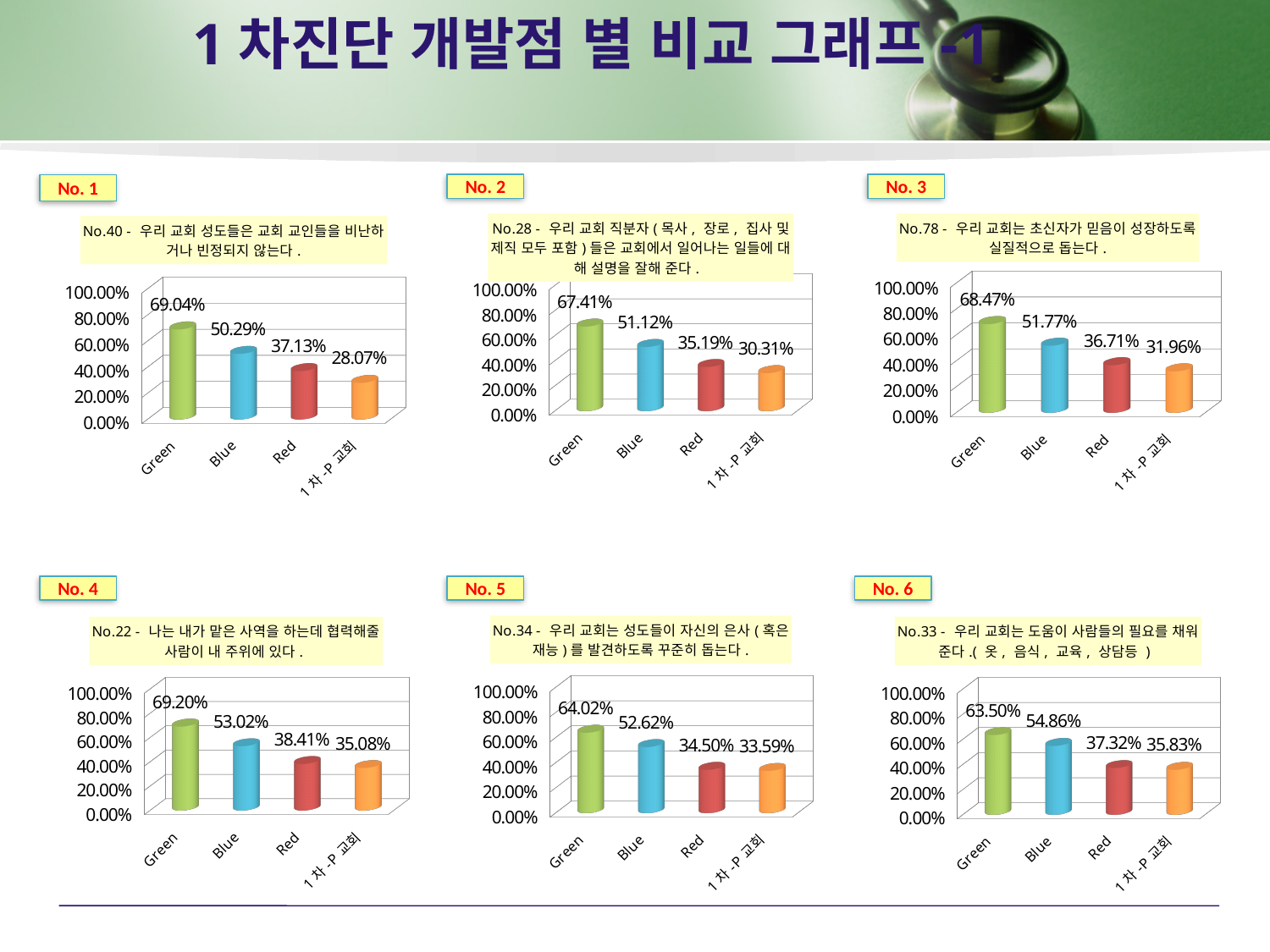
In the No. 3 chart, which category has the lowest value? 1차-P 교회 In the No. 6 chart, what is the value for Blue? 54.86% How many charts are shown on the slide? 6 In the No. 2 chart, what is the value for 1차-P 교회? 30.31% How many categories are shown in the No. 2 chart? 4 In the No. 4 chart, do the values rise or fall from Green to 1차-P 교회? fall In the No. 4 chart, which category has the highest value? Green In the No. 1 chart, what is the value for Green? 69.04% In the No. 1 chart, is the value for Blue greater or less than 40.00%? greater What kind of chart is the No. 3 chart? bar chart In the No. 5 chart, what is the difference between the Green and Blue values? 11.40% In the No. 6 chart, which is larger, the value for Red or the value for 1차-P 교회? Red